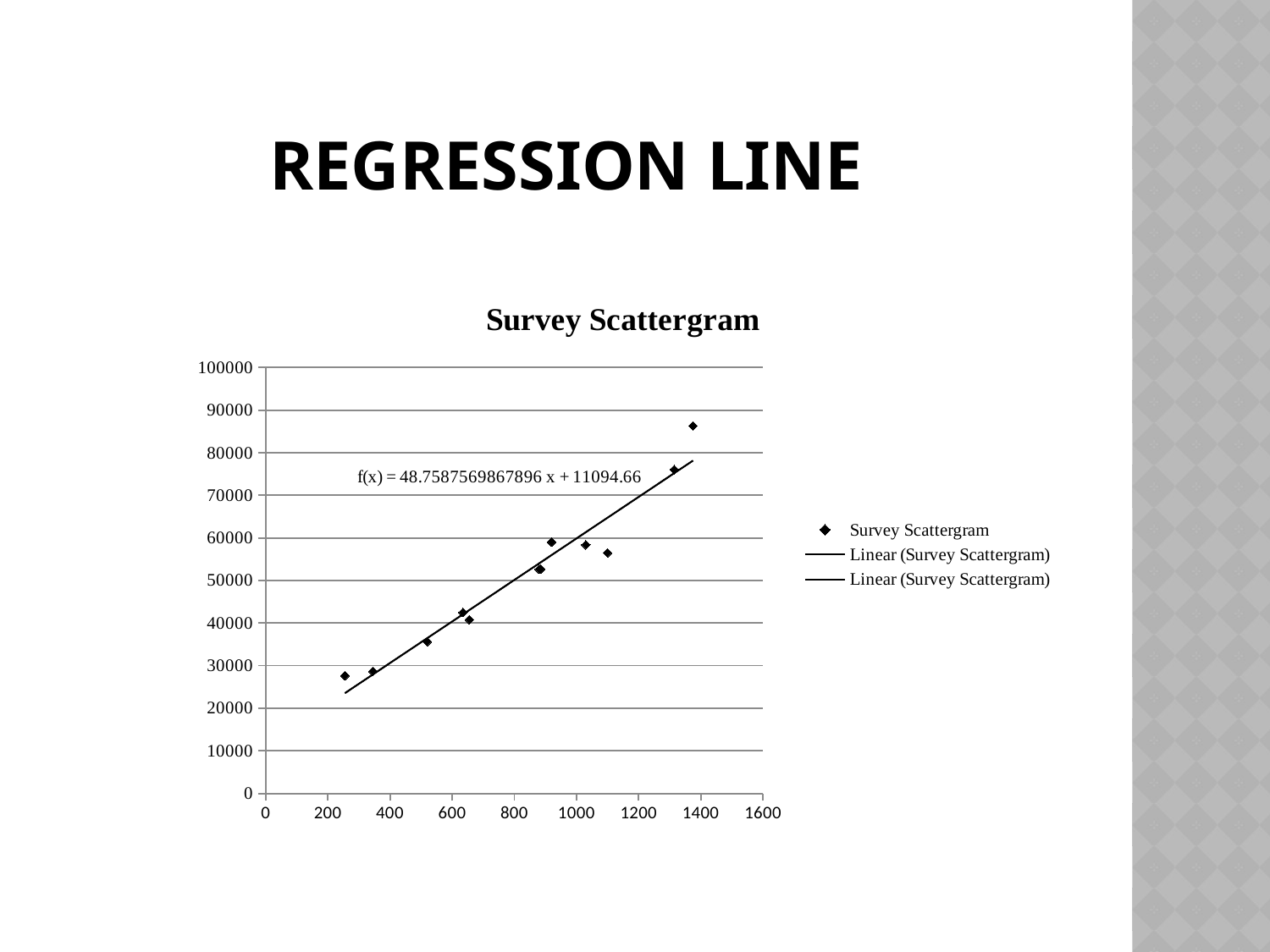
What is the slope of the regression line shown in the equation on the chart? 48.7587569867896 Is the y value of the rightmost data point greater or less than 80000? greater What is the trendline equation shown on the chart? f(x) = 48.7587569867896 x + 11094.66 Do the plotted values rise or fall as x increases along the x axis? rise What is the maximum value shown on the y axis? 100000 How many entries does the legend list? 3 What kind of chart is the Survey Scattergram? scatter chart Which data point has the highest y value, the leftmost or the rightmost? the rightmost Is the y value of the leftmost data point greater or less than 30000? less What is the intercept of the regression line shown in the equation on the chart? 11094.66 What is the title of the chart? Survey Scattergram